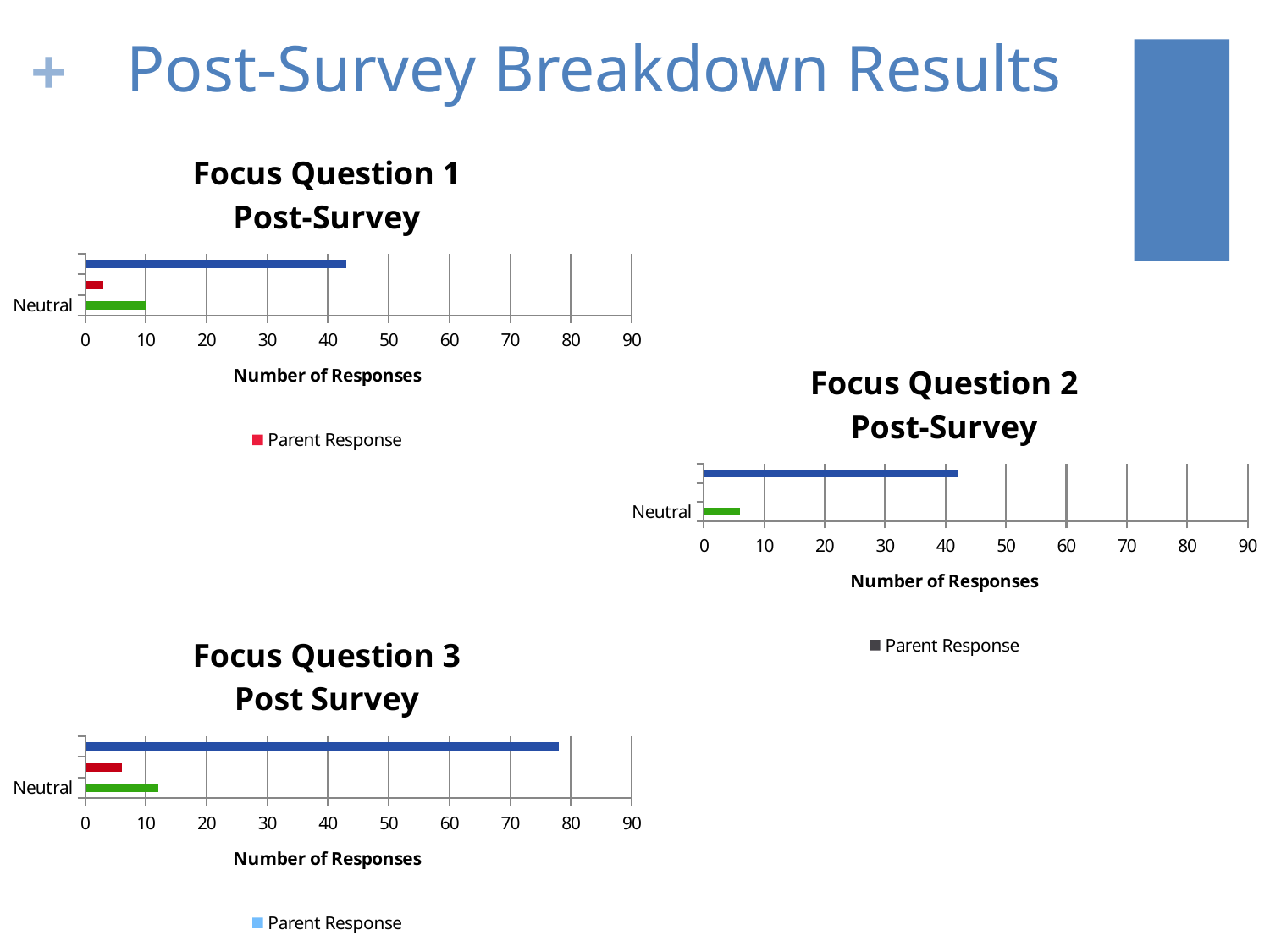
In the Focus Question 2 Post-Survey chart, is the value for Neutral greater or less than 10? less How many bars are plotted in the Focus Question 3 Post Survey chart? 3 How many bars are plotted in the Focus Question 2 Post-Survey chart? 2 In the Focus Question 1 Post-Survey chart, is the value for Neutral greater or less than 20? less How many entries does the legend of the Focus Question 2 Post-Survey chart list? 1 What is the legend entry shown under the Focus Question 1 Post-Survey chart? Parent Response What is the x-axis title of the Focus Question 3 Post Survey chart? Number of Responses In the Focus Question 3 Post Survey chart, is the longest bar greater or less than 70? greater In the Focus Question 1 Post-Survey chart, is the Neutral bar longer or shorter than the top blue bar? shorter What kind of chart is the Focus Question 1 Post-Survey chart? bar chart